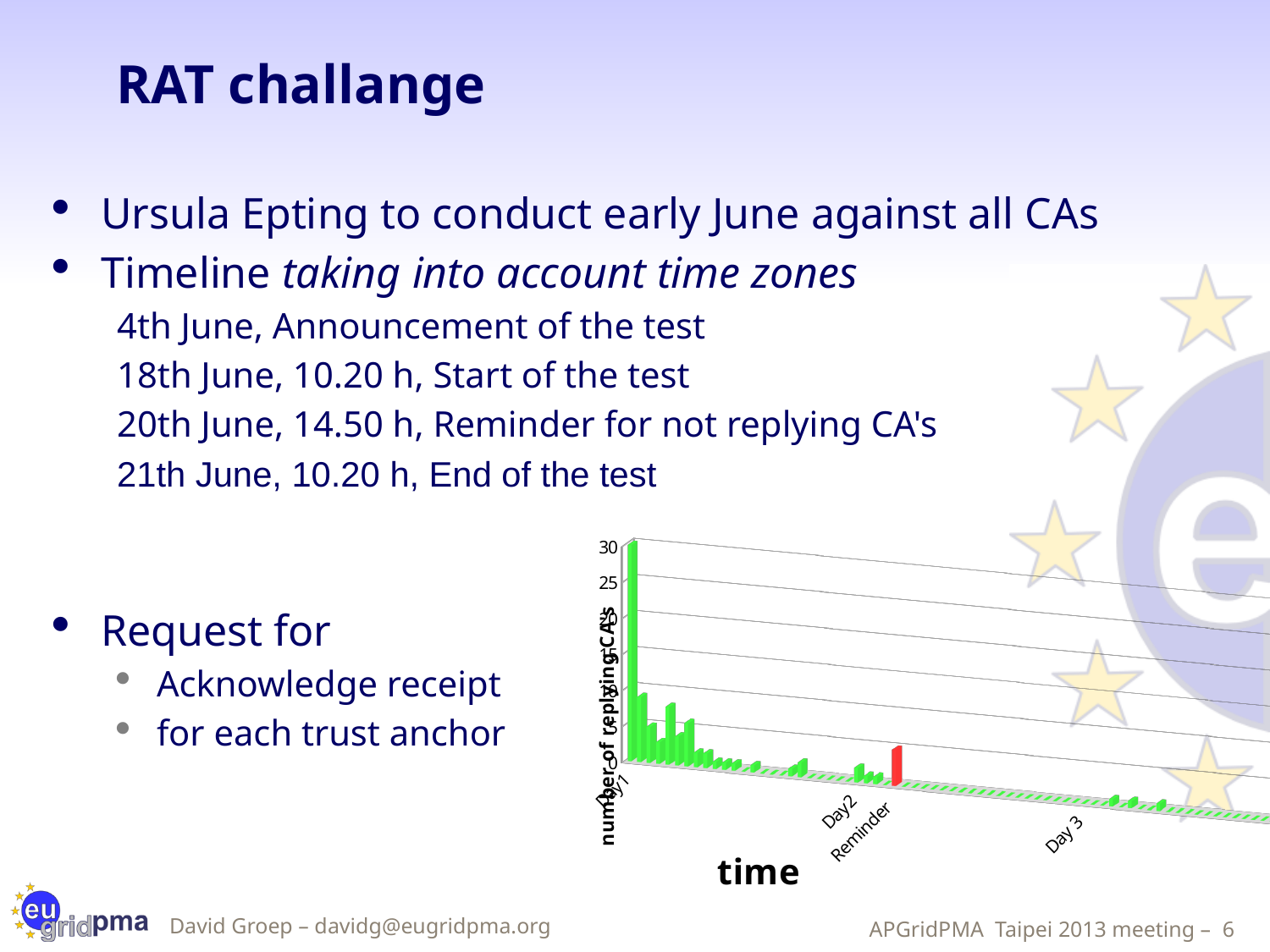
What is the title of the y axis of the chart? number of replying CA's What kind of chart is shown on the slide? bar chart Is the tallest bar at Day 1 larger or smaller than the red bar at Reminder? larger How many labels are shown on the x axis of the chart? 4 Which x-axis label has the highest bar? Day 1 Do the bar values generally rise or fall along the x axis from Day 1 to Day 3? fall Are the bars at Day 3 greater or less than 5? less What is the title of the x axis of the chart? time What is the highest tick value shown on the y axis? 30 Is the value of the tallest bar at Day 1 greater or less than 25? greater Is the value of the red bar at Reminder greater or less than 10? less